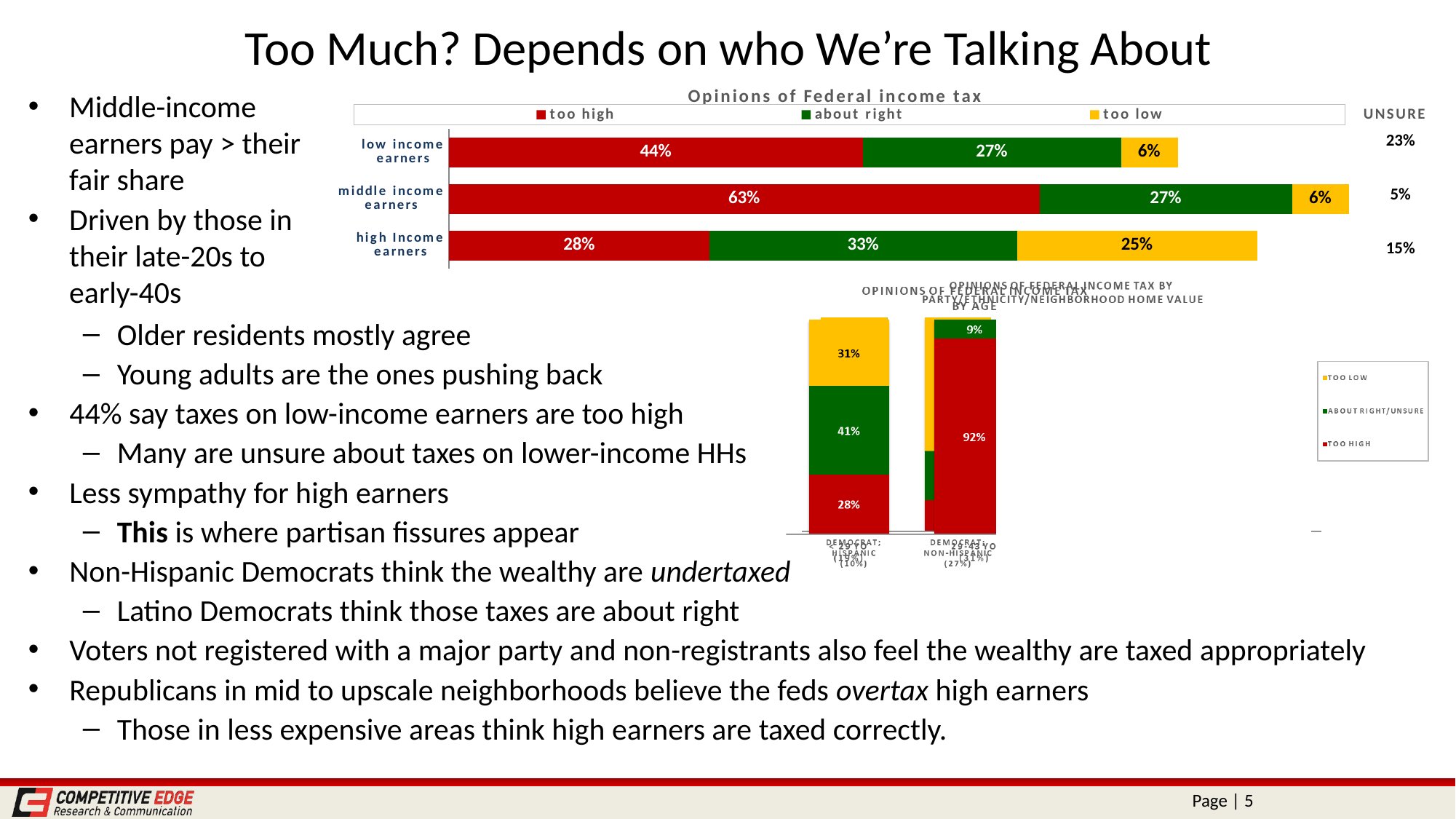
In the 'Opinions of Federal income tax' chart, which has the larger 'too low' value: high income earners or middle income earners? high income earners In the 'Opinions of Federal income tax' chart, what percentage say taxes on low income earners are about right? 27% How many series does the legend of the 'Opinions of Federal income tax' chart list? 3 In the 'Opinions of Federal income tax' chart, what is the 'unsure' percentage for low income earners? 23% In the 'Opinions of Federal income tax' chart, what is the total of the three stacked segments for high income earners? 86% In the 'Opinions of Federal income tax' chart, how many percentage points higher is the 'too high' value for middle income earners than for low income earners? 19 percentage points What kind of chart is the 'Opinions of Federal income tax' chart at the top of the slide? Stacked horizontal bar chart In the 'Opinions of Federal income tax' chart, what percentage of respondents say taxes on middle income earners are too high? 63% In the 'Opinions of Federal income tax' chart, which earner group has the lowest 'too high' percentage? high income earners In the 'Opinions of Federal income tax' chart, what percentage say taxes on high income earners are too low? 25% In the 'Opinions of Federal income tax' chart, which earner group has the highest 'too high' percentage? middle income earners How many earner groups are shown in the 'Opinions of Federal income tax' chart? 3